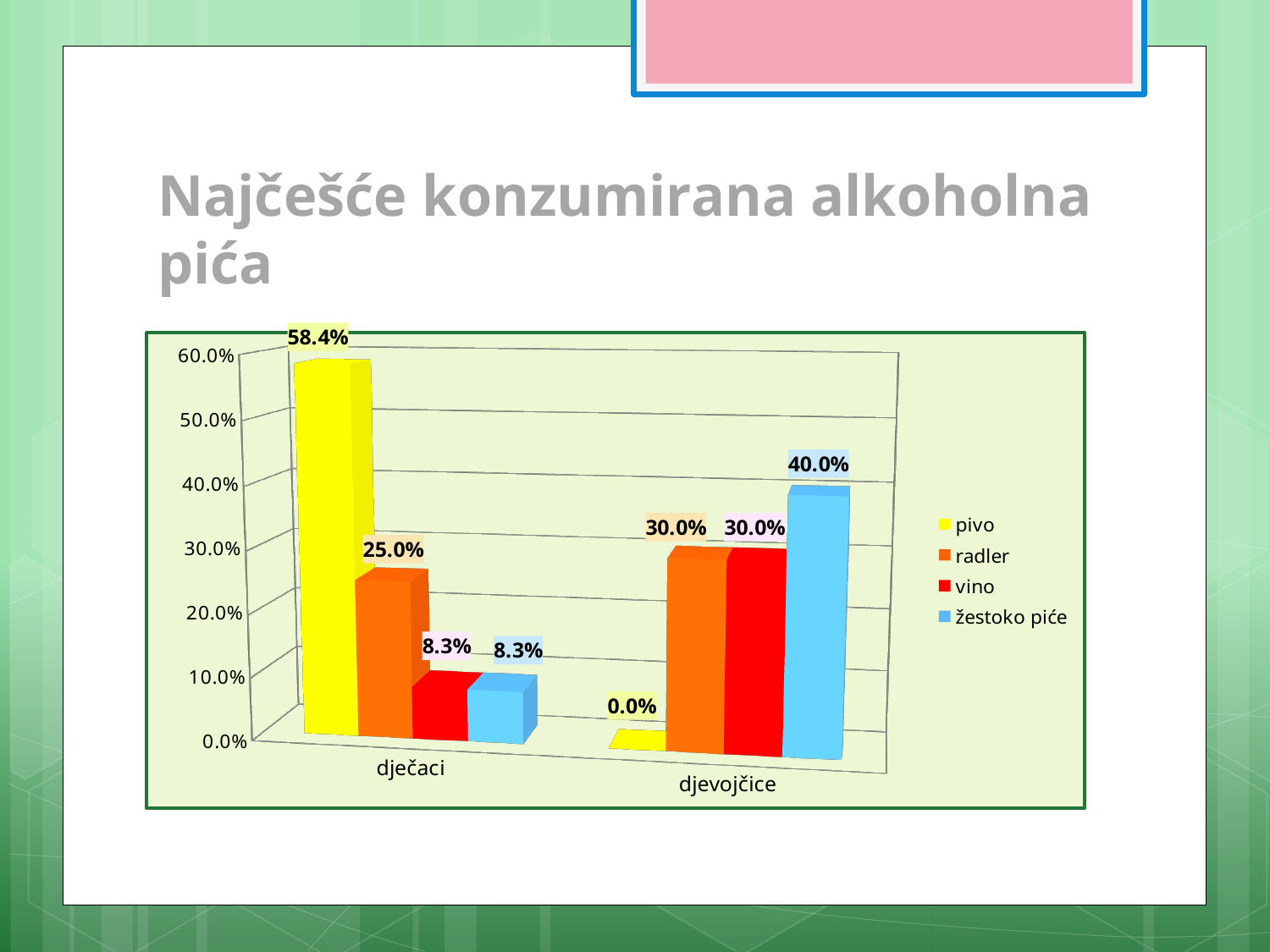
Which drink has the highest value among dječaci? pivo Which is larger: the radler value for dječaci or the radler value for djevojčice? djevojčice What is the value for pivo among dječaci? 58.4% What kind of chart is shown on the slide? bar chart What is the difference between the žestoko piće value for djevojčice and for dječaci? 31.7% What is the difference between the pivo value for dječaci and the pivo value for djevojčice? 58.4% What is the value for pivo among djevojčice? 0.0% How many categories are shown on the x axis? 2 Which drink has the lowest value among djevojčice? pivo What is the value for žestoko piće among djevojčice? 40.0% What is the value for radler among dječaci? 25.0% How many series does the legend list? 4